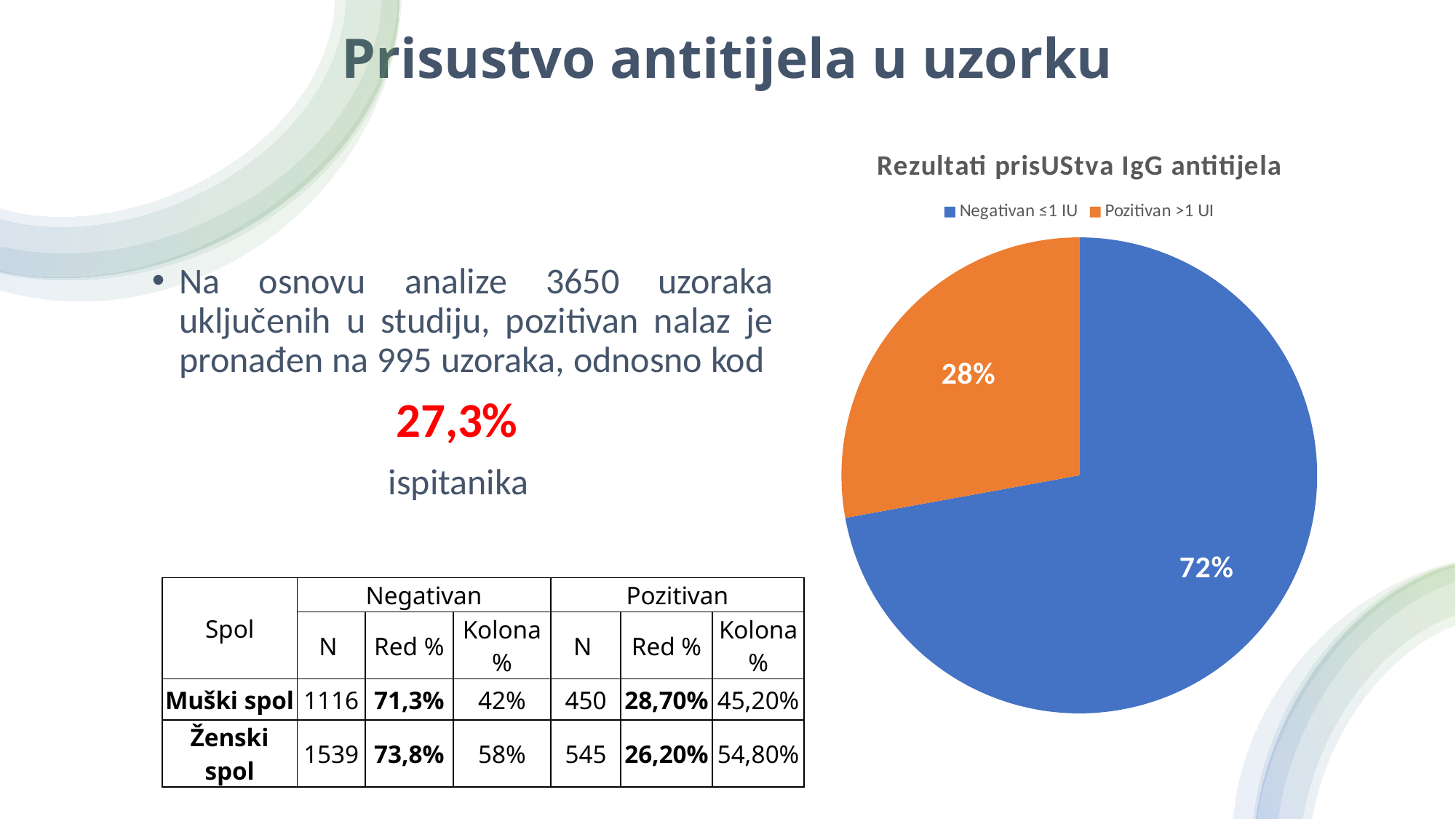
What share of the pie is labelled for Negativan ≤1 IU? 72% Which slice of the pie chart is the smallest? Pozitivan >1 UI What share of the pie is labelled for Pozitivan >1 UI? 28% Which slice of the pie chart is the largest? Negativan ≤1 IU What is the difference in percentage points between the Negativan ≤1 IU slice and the Pozitivan >1 UI slice? 44 Which is larger in the pie chart, Negativan ≤1 IU or Pozitivan >1 UI? Negativan ≤1 IU What colour is the Pozitivan >1 UI slice in the pie chart? orange What kind of chart is shown on the slide? pie chart What is the title of the chart? Rezultati prisUStva IgG antitijela How many entries does the chart legend list? 2 How many slices does the pie chart have? 2